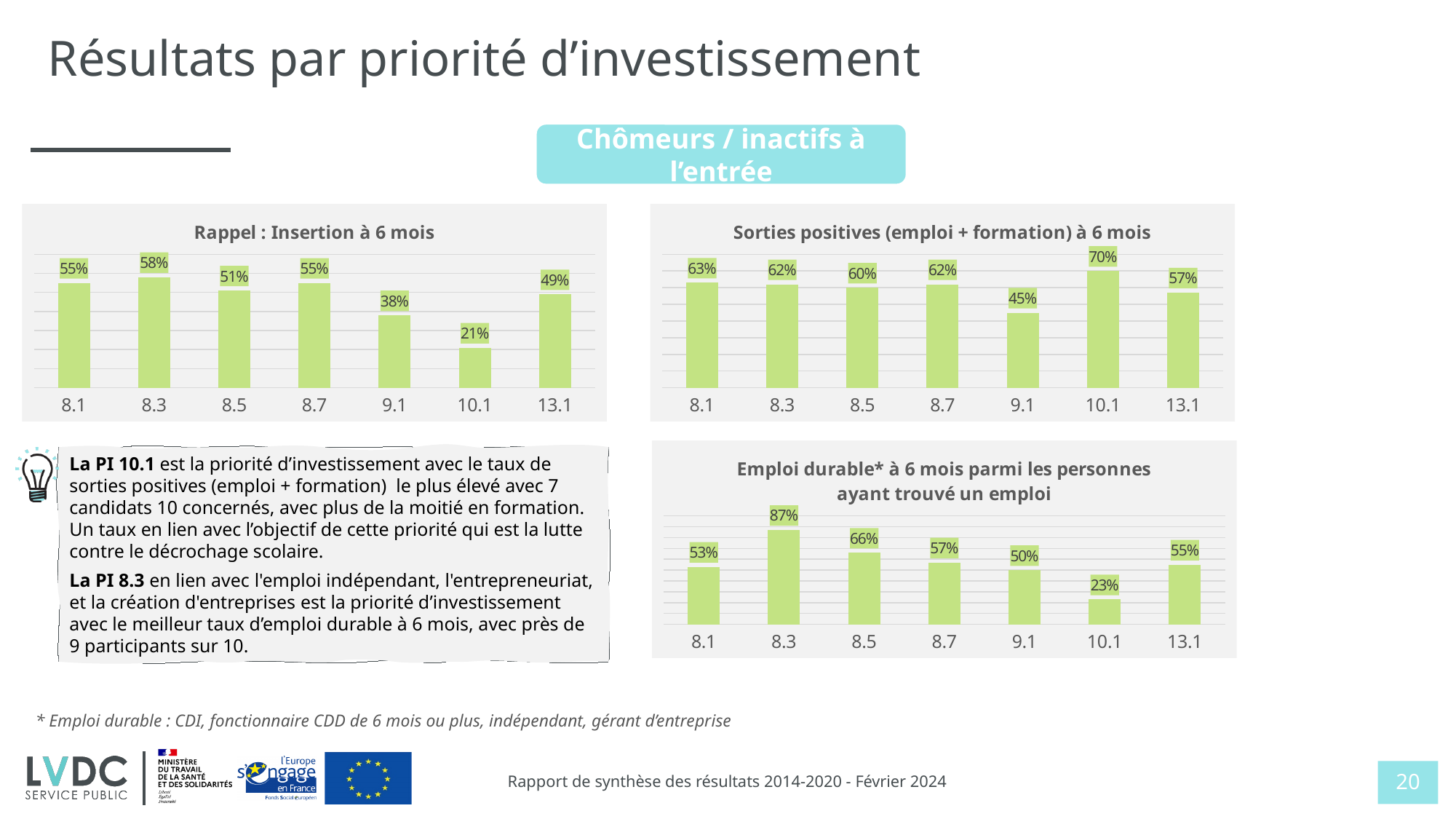
In the chart 'Sorties positives (emploi + formation) à 6 mois', which category has the lowest value? 9.1 In the chart 'Sorties positives (emploi + formation) à 6 mois', what is the difference between the values for 10.1 and 9.1? 25% In the chart 'Emploi durable* à 6 mois parmi les personnes ayant trouvé un emploi', which category has the lowest value? 10.1 In the chart 'Rappel : Insertion à 6 mois', which category has the highest value? 8.3 How many categories are shown in the chart 'Rappel : Insertion à 6 mois'? 7 In the chart 'Emploi durable* à 6 mois parmi les personnes ayant trouvé un emploi', what is the value for 8.3? 87% In the chart 'Rappel : Insertion à 6 mois', which category has the lowest value? 10.1 What type of chart is 'Sorties positives (emploi + formation) à 6 mois'? Bar chart In the chart 'Sorties positives (emploi + formation) à 6 mois', what is the value for 10.1? 70% In the chart 'Rappel : Insertion à 6 mois', what is the difference between the values for 8.3 and 10.1? 37% In the chart 'Rappel : Insertion à 6 mois', what is the value for 9.1? 38% In the chart 'Emploi durable* à 6 mois parmi les personnes ayant trouvé un emploi', which is larger, the value for 8.5 or the value for 13.1? 8.5